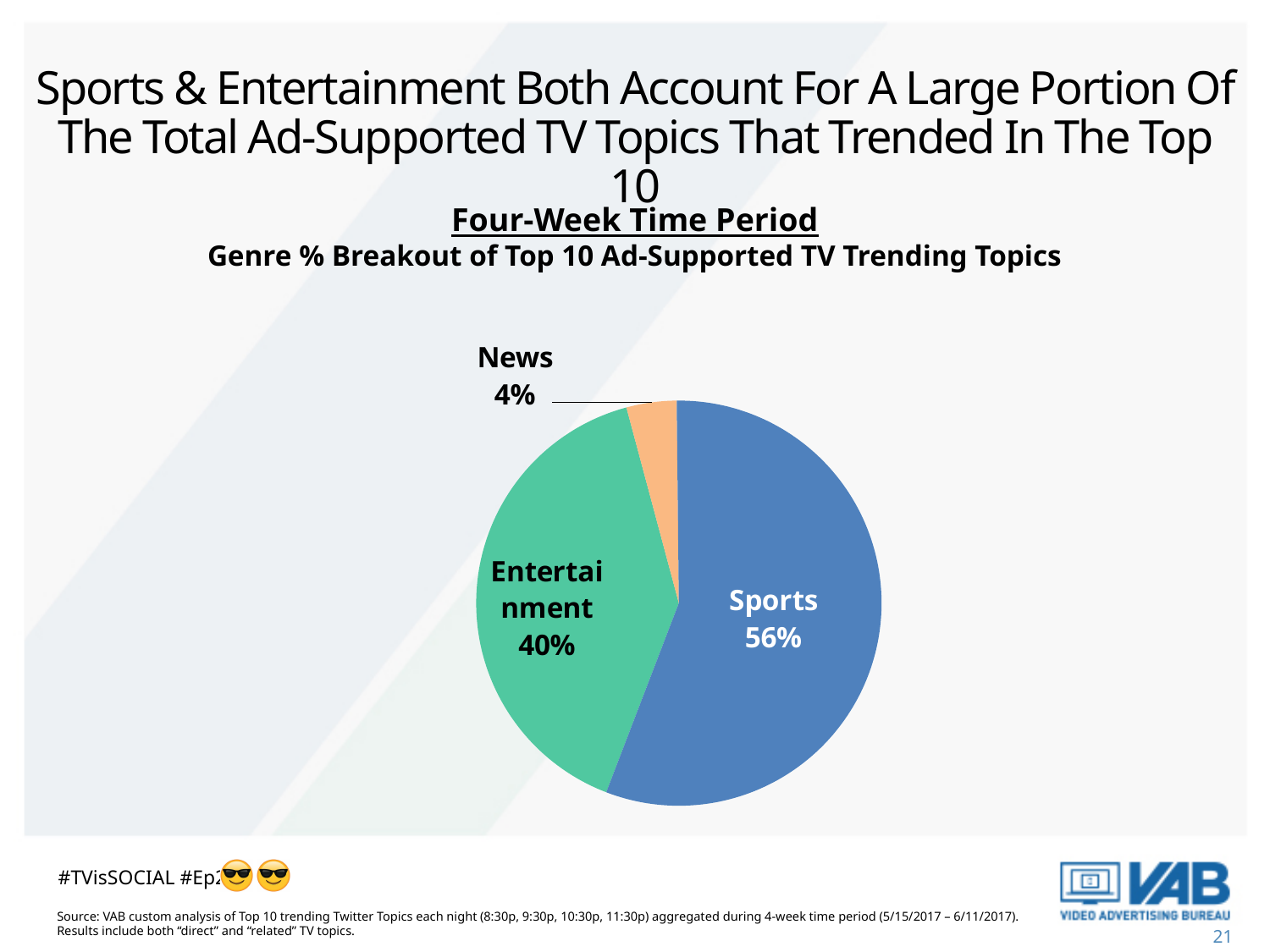
What is the difference in percentage points between Sports and Entertainment? 16 Which genre has the largest slice of the pie? Sports What share of the pie does Sports account for? 56% What is the value shown for News? 4% Which is larger, the share for Entertainment or the share for News? Entertainment How many genre slices does the pie chart have? 3 What is the subtitle printed directly above the pie chart? Genre % Breakout of Top 10 Ad-Supported TV Trending Topics What kind of chart is shown on the slide? pie chart What is the difference in percentage points between Entertainment and News? 36 What share of the pie does Entertainment account for? 40% What is the combined share of Sports and Entertainment? 96% Which genre has the smallest slice of the pie? News